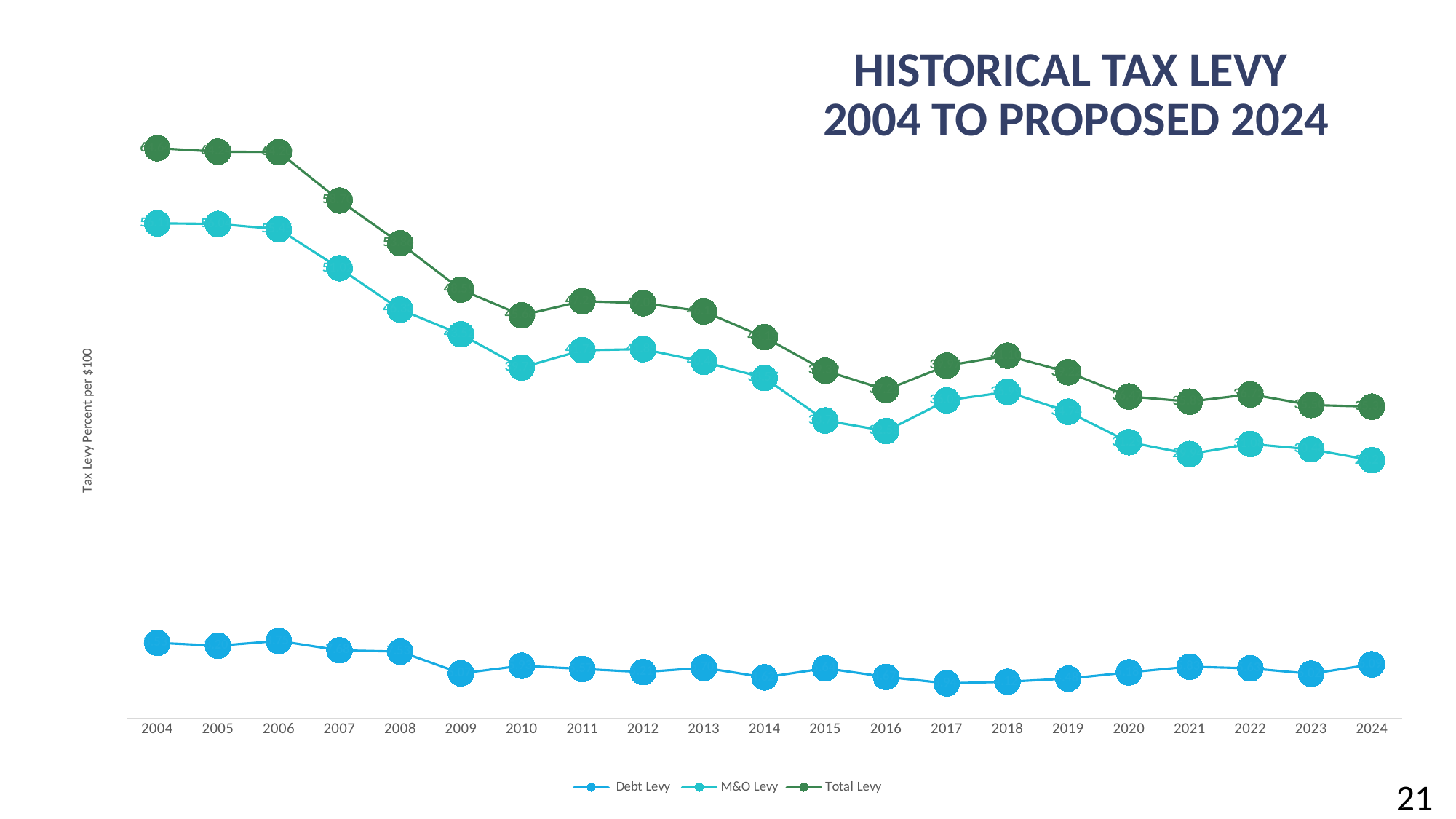
Does the Total Levy generally rise or fall from 2004 to 2024? Fall What kind of chart is shown on the slide? Line chart For the Debt Levy, which is larger: the value in 2004 or the value in 2009? 2004 What is the title of the chart? Historical Tax Levy 2004 to Proposed 2024 Does the M&O Levy generally rise or fall from 2004 to 2024? Fall How many series does the legend list? 3 For the M&O Levy, which is larger: the value in 2004 or the value in 2024? 2004 Which series has the highest values across all years? Total Levy What is the label on the vertical axis? Tax Levy Percent per $100 How many years are plotted along the x axis? 21